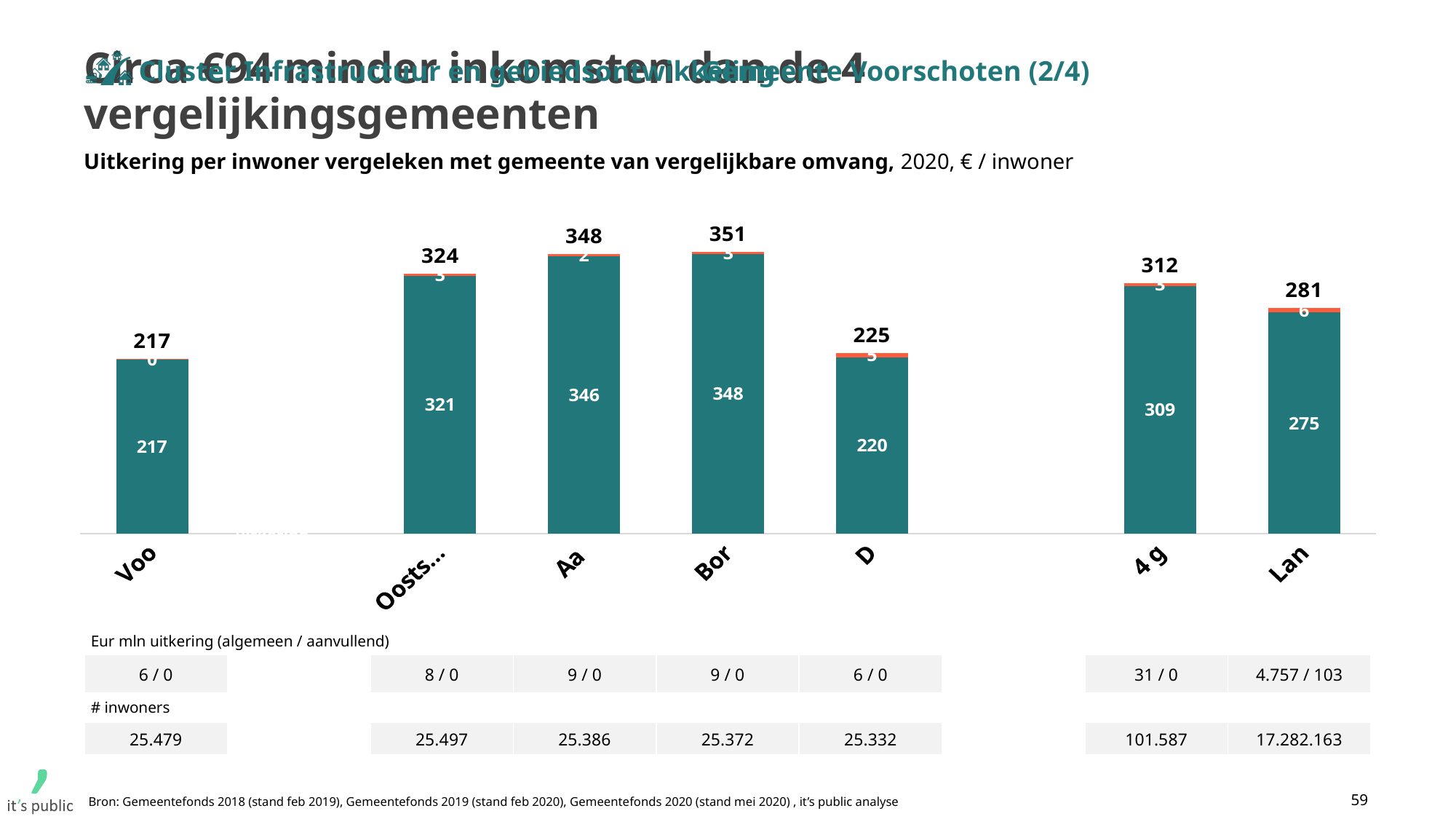
What is the value of the teal (lower) segment for Aa? 346 Which category has the lowest total value? Voo What is the difference between the total for Aa and the total for Oosts...? 24 Which category has the highest total value? Bor In what unit are the chart values expressed, according to the chart subtitle? € / inwoner Which has a larger total, Oosts... or Lan? Oosts... Is the total value for D greater or less than 300? less What is the difference between the total for Bor and the total for Voo? 134 What is the value of the teal (lower) segment for 4 g? 309 How many bars are shown in the chart? 7 What is the total value shown above the bar for Voo? 217 What kind of chart is shown on the slide? bar chart